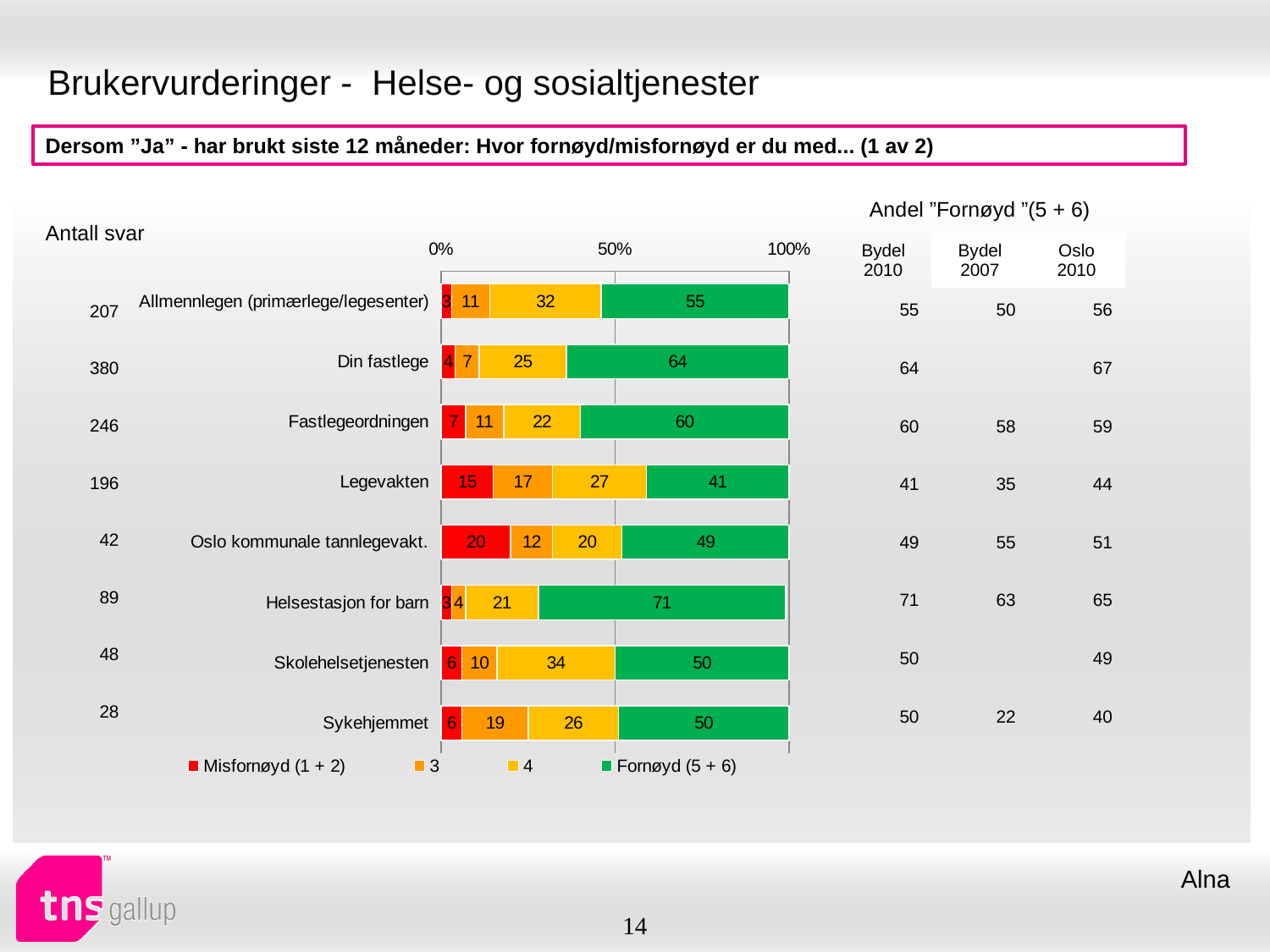
What is the total of the stacked bar for Din fastlege? 100 What is the value of the Misfornøyd (1 + 2) segment for Oslo kommunale tannlegevakt.? 20 How many categories are shown in the bar chart? 8 What kind of chart is shown on the slide? Stacked bar chart What is the value of the Fornøyd (5 + 6) segment for Legevakten? 41 Which has the larger Misfornøyd (1 + 2) value, Legevakten or Fastlegeordningen? Legevakten What is the value of the '4' segment for Skolehelsetjenesten? 34 How much larger is the Fornøyd (5 + 6) value for Din fastlege than for Allmennlegen (primærlege/legesenter)? 9 How many series does the legend list? 4 What is the first entry in the chart legend? Misfornøyd (1 + 2) Which category has the highest Fornøyd (5 + 6) value? Helsestasjon for barn Which category has the lowest Fornøyd (5 + 6) value? Legevakten